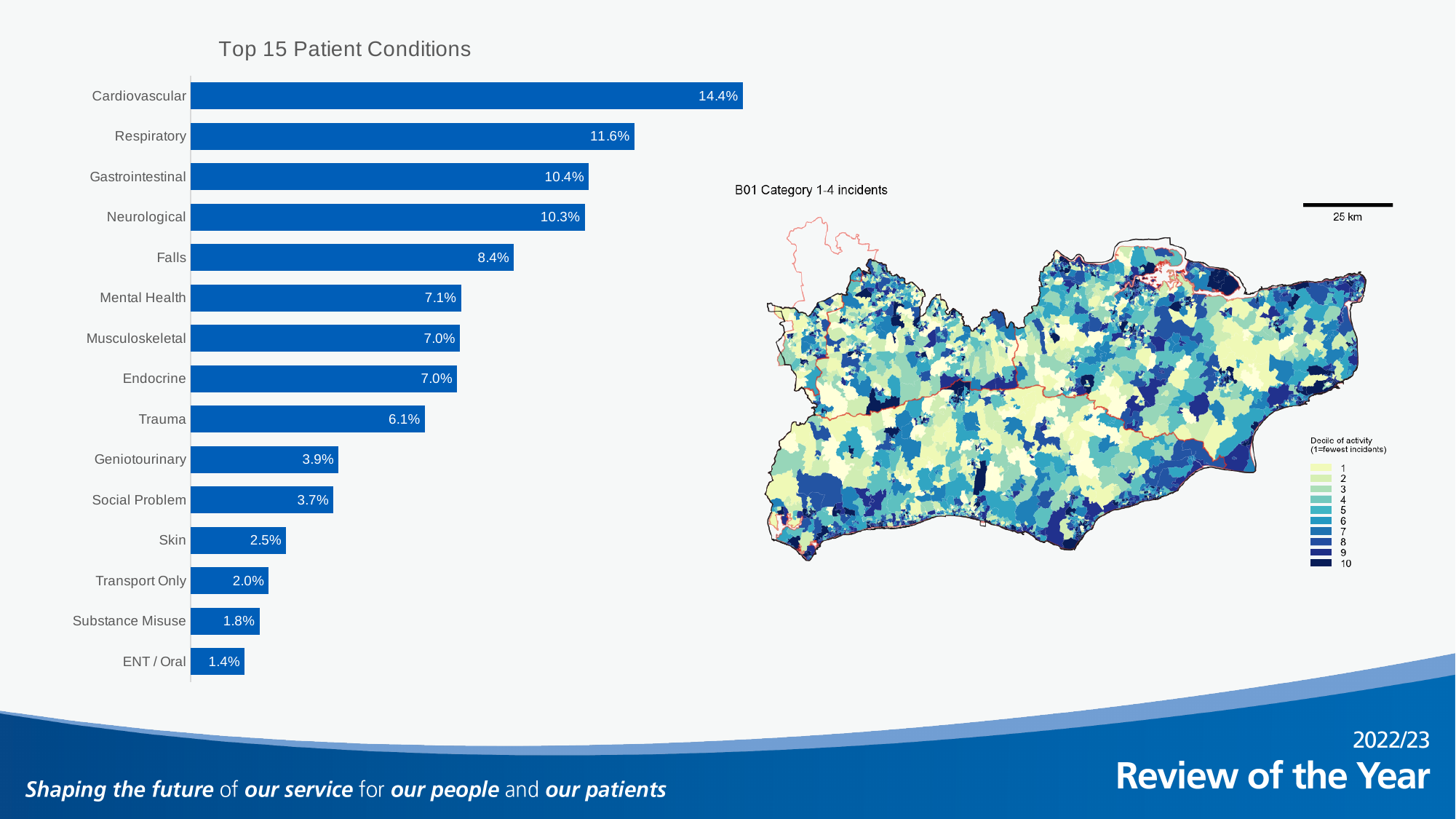
What is the difference between the values for Cardiovascular and Respiratory in the Top 15 Patient Conditions chart? 2.8% What is the value for Falls in the Top 15 Patient Conditions chart? 8.4% In the Top 15 Patient Conditions chart, which is larger: Skin or Transport Only? Skin In the Top 15 Patient Conditions chart, which is larger: Mental Health or Trauma? Mental Health Which condition has the highest value in the Top 15 Patient Conditions chart? Cardiovascular How many conditions are shown in the Top 15 Patient Conditions chart? 15 What is the title of the bar chart on the left of the slide? Top 15 Patient Conditions What is the value for Cardiovascular in the Top 15 Patient Conditions chart? 14.4% What kind of chart is the Top 15 Patient Conditions chart? Bar chart What is the difference between the values for Trauma and Geniotourinary in the Top 15 Patient Conditions chart? 2.2% Which condition has the lowest value in the Top 15 Patient Conditions chart? ENT / Oral What is the value for Social Problem in the Top 15 Patient Conditions chart? 3.7%